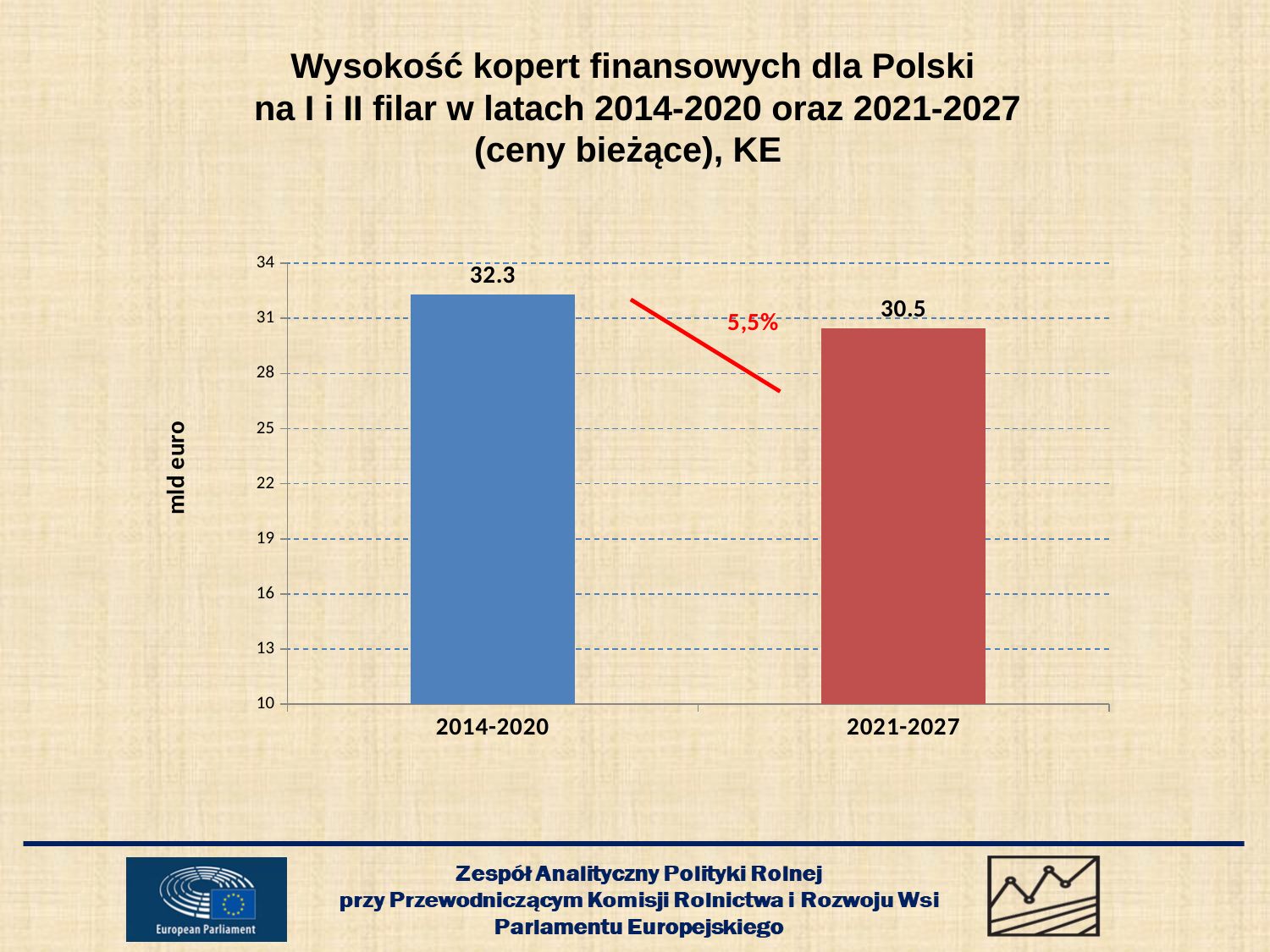
What unit is shown on the y-axis label? mld euro Is the value for 2021-2027 greater or less than 31? less How many bars are shown in the chart? 2 Which period has the higher value? 2014-2020 Which period has the lower value? 2021-2027 Do the values rise or fall from 2014-2020 to 2021-2027? fall Is the value for 2014-2020 larger or smaller than the value for 2021-2027? larger What is the value for 2021-2027? 30.5 What is the value for 2014-2020? 32.3 What is the difference between the values for 2014-2020 and 2021-2027? 1.8 Is the value for 2014-2020 greater or less than 31? greater What kind of chart is shown on the slide? bar chart